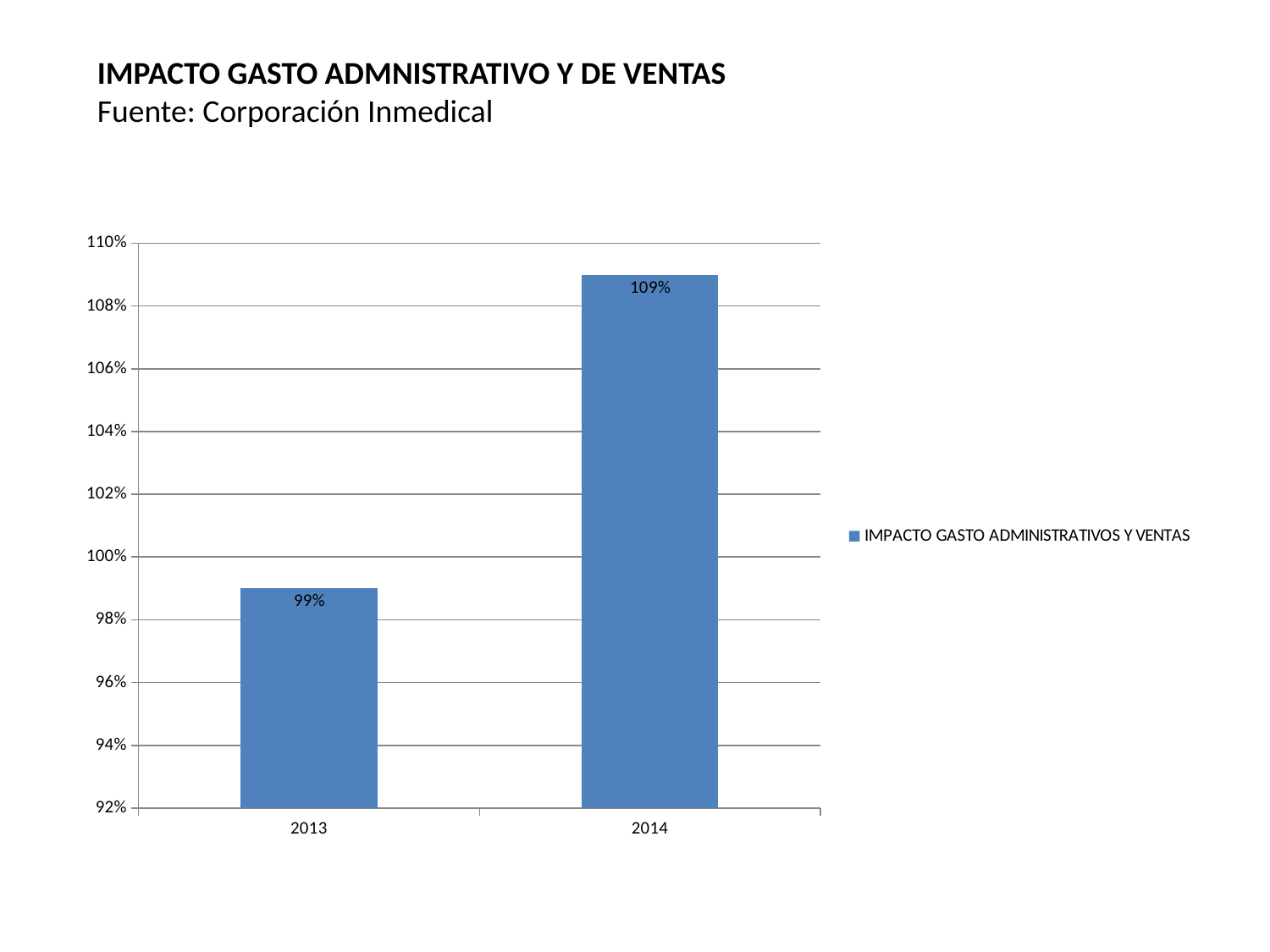
Which is larger, the value for 2013 or the value for 2014? 2014 What is the difference between the values for 2014 and 2013? 10% What is the value for 2014? 109% What kind of chart is shown on the slide? bar chart What is the value for 2013? 99% Do the values rise or fall from 2013 to 2014? rise Which year has the lowest value? 2013 Is the value for 2014 greater or less than 106%? greater How many series does the legend list? 1 Is the value for 2013 greater or less than 100%? less Which year has the highest value? 2014 How many years are shown on the x axis? 2